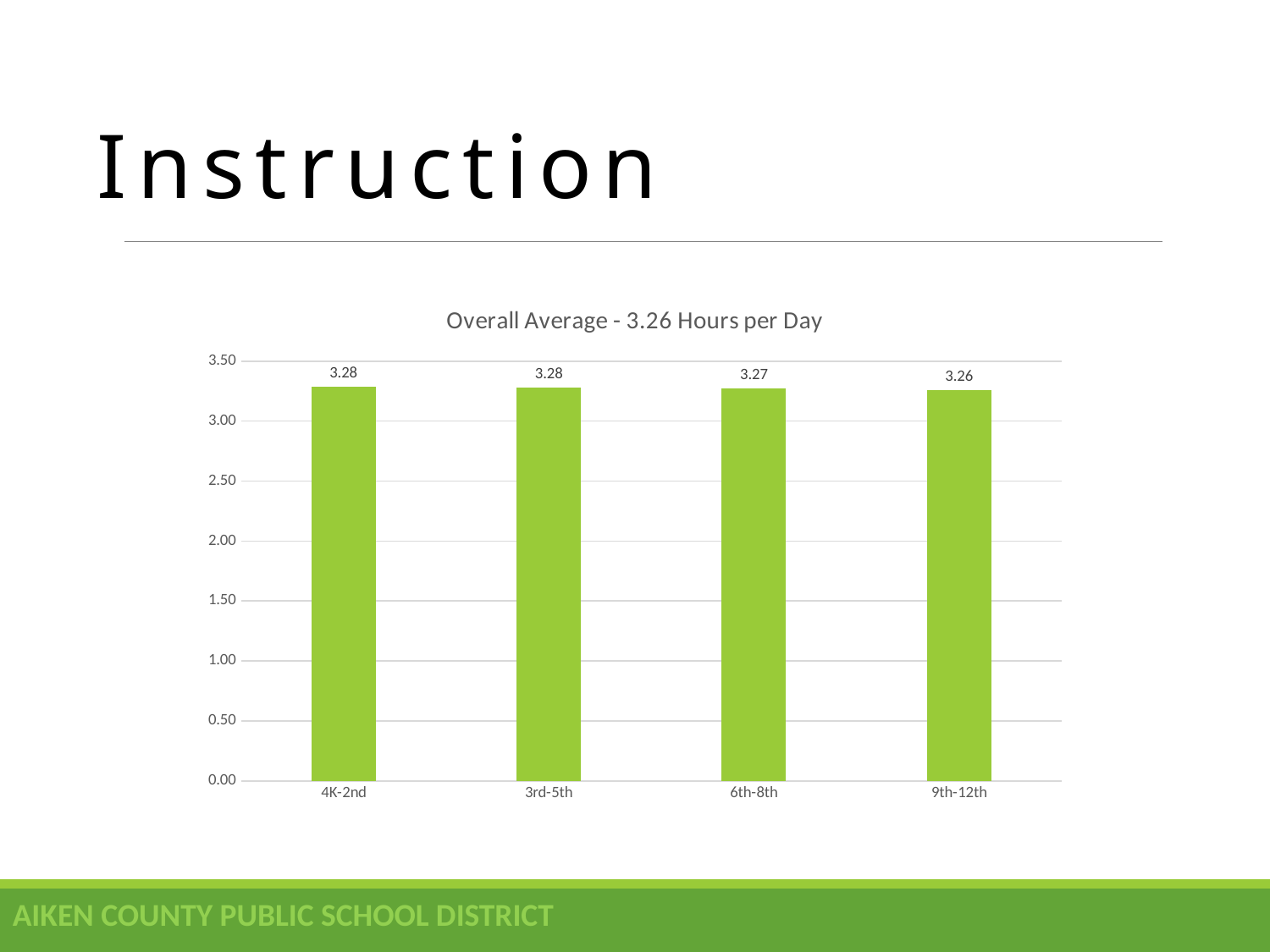
What is the value for 3rd-5th? 3.28 How many grade bands are shown on the x axis? 4 Is the value for 9th-12th greater or less than 3.00? greater Which is larger, the value for 6th-8th or the value for 9th-12th? 6th-8th Do the values rise or fall from 4K-2nd to 9th-12th? fall What is the value for 9th-12th? 3.26 What is the difference between the values for 4K-2nd and 9th-12th? 0.02 What kind of chart is shown on the slide? bar chart What is the title of the chart? Overall Average - 3.26 Hours per Day What is the value for 4K-2nd? 3.28 What is the value for 6th-8th? 3.27 Which grade band has the lowest value? 9th-12th